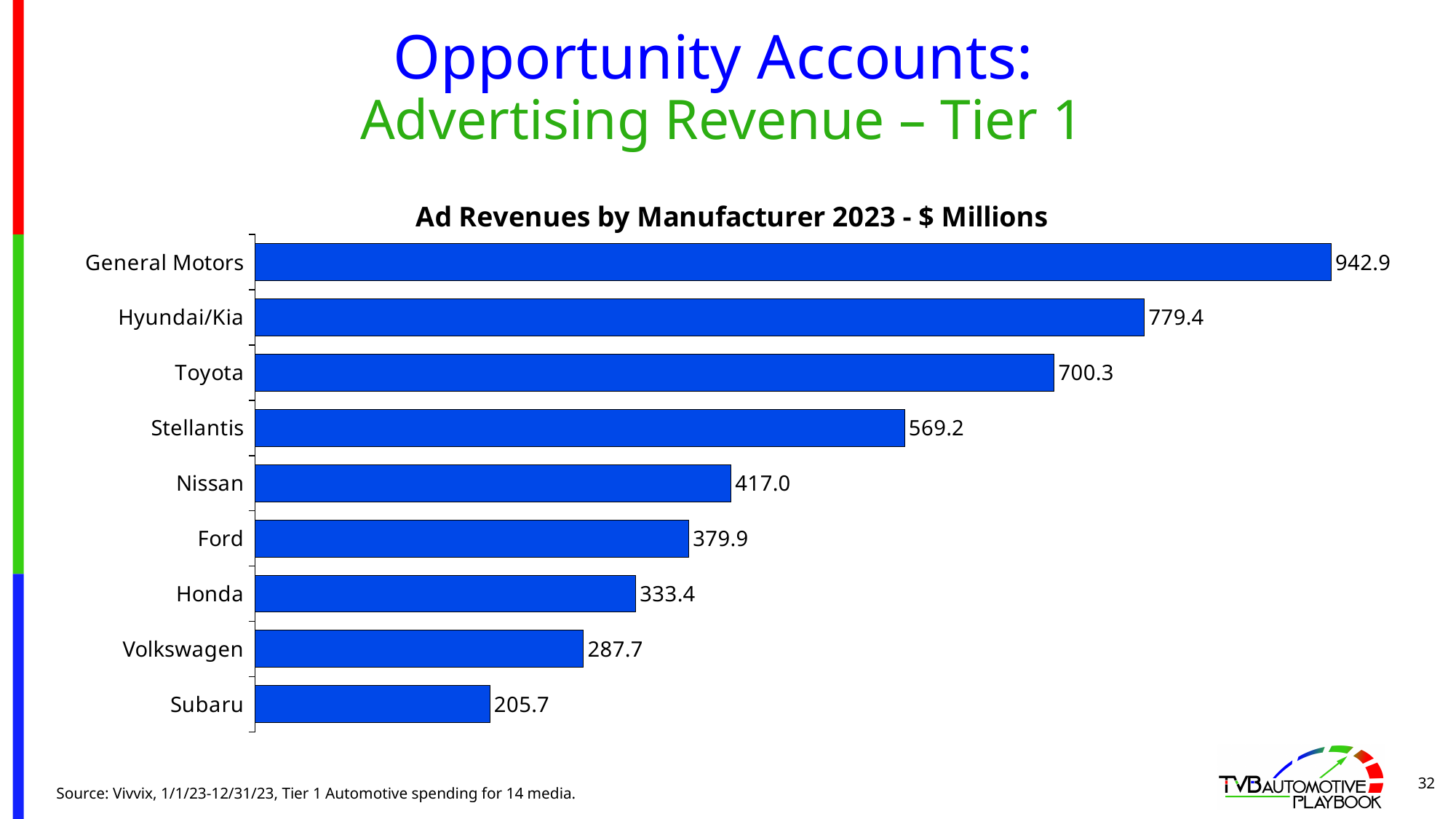
What is the difference between the ad revenue values for General Motors and Hyundai/Kia? 163.5 Which has a larger ad revenue value, Stellantis or Honda? Stellantis What kind of chart is shown on the slide? Bar chart What is the ad revenue value for Volkswagen? 287.7 How many manufacturers are shown in the chart? 9 What is the ad revenue value for Toyota? 700.3 Which manufacturer has the highest ad revenue? General Motors Which manufacturer has the lowest ad revenue? Subaru What is the ad revenue value for Honda? 333.4 What is the title of the chart? Ad Revenues by Manufacturer 2023 - $ Millions What is the difference between the ad revenue values for Nissan and Ford? 37.1 Which has a larger ad revenue value, Ford or Subaru? Ford